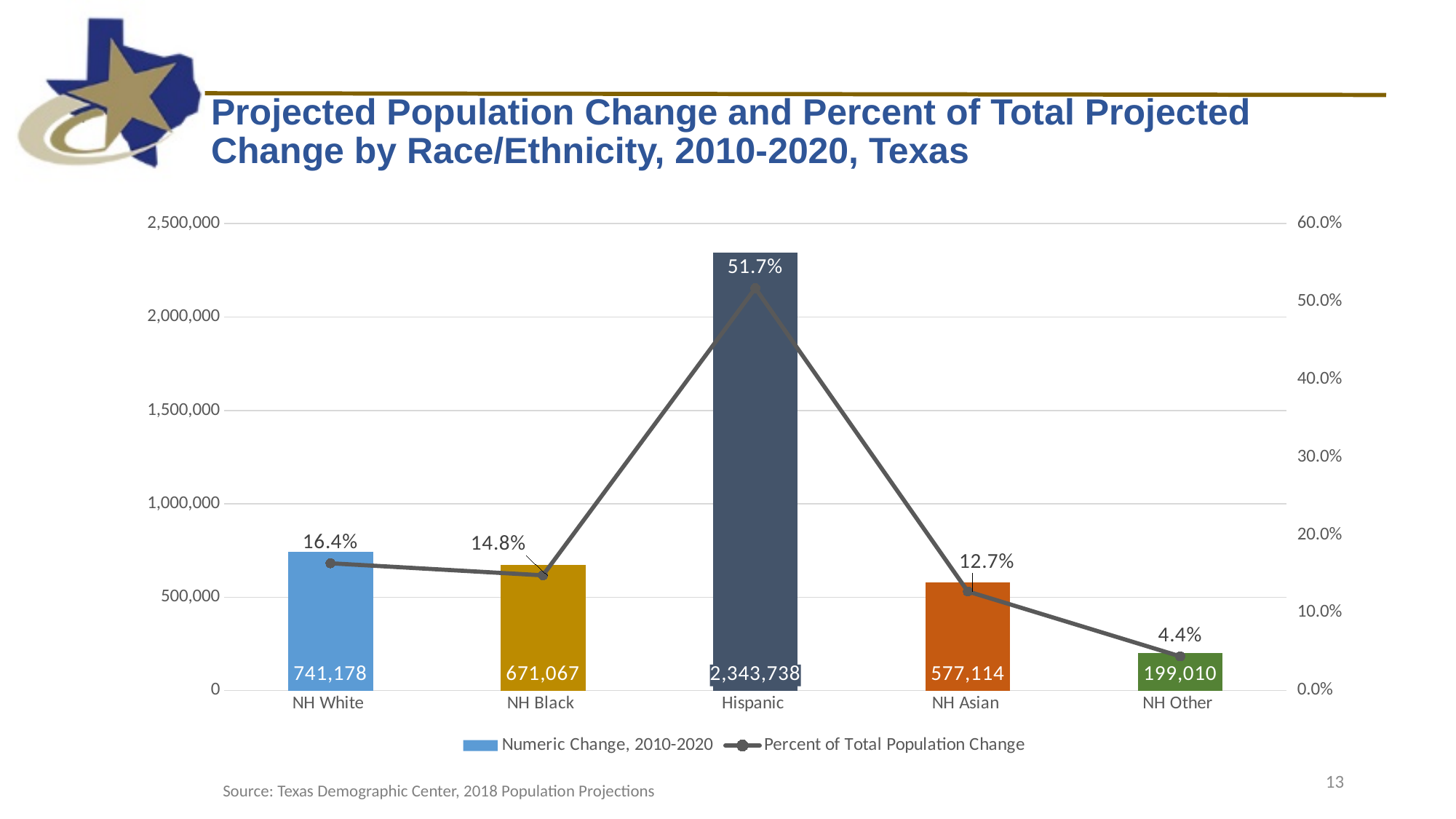
What kind of chart is used to show the Numeric Change, 2010-2020 series? Bar chart How many series does the legend list? 2 Which race/ethnicity group has the highest Numeric Change, 2010-2020? Hispanic What is the Numeric Change, 2010-2020 for Hispanic? 2,343,738 Which has a larger Numeric Change, 2010-2020: NH Black or NH Asian? NH Black What is the Percent of Total Population Change for NH Asian? 12.7% Is the Numeric Change, 2010-2020 for Hispanic greater or less than 2,000,000? greater What is the Numeric Change, 2010-2020 for NH Other? 199,010 Which race/ethnicity group has the lowest Percent of Total Population Change? NH Other How many race/ethnicity categories are shown on the x axis? 5 What is the difference in Numeric Change, 2010-2020 between NH White and NH Black? 70,111 What is the source cited below the chart? Texas Demographic Center, 2018 Population Projections